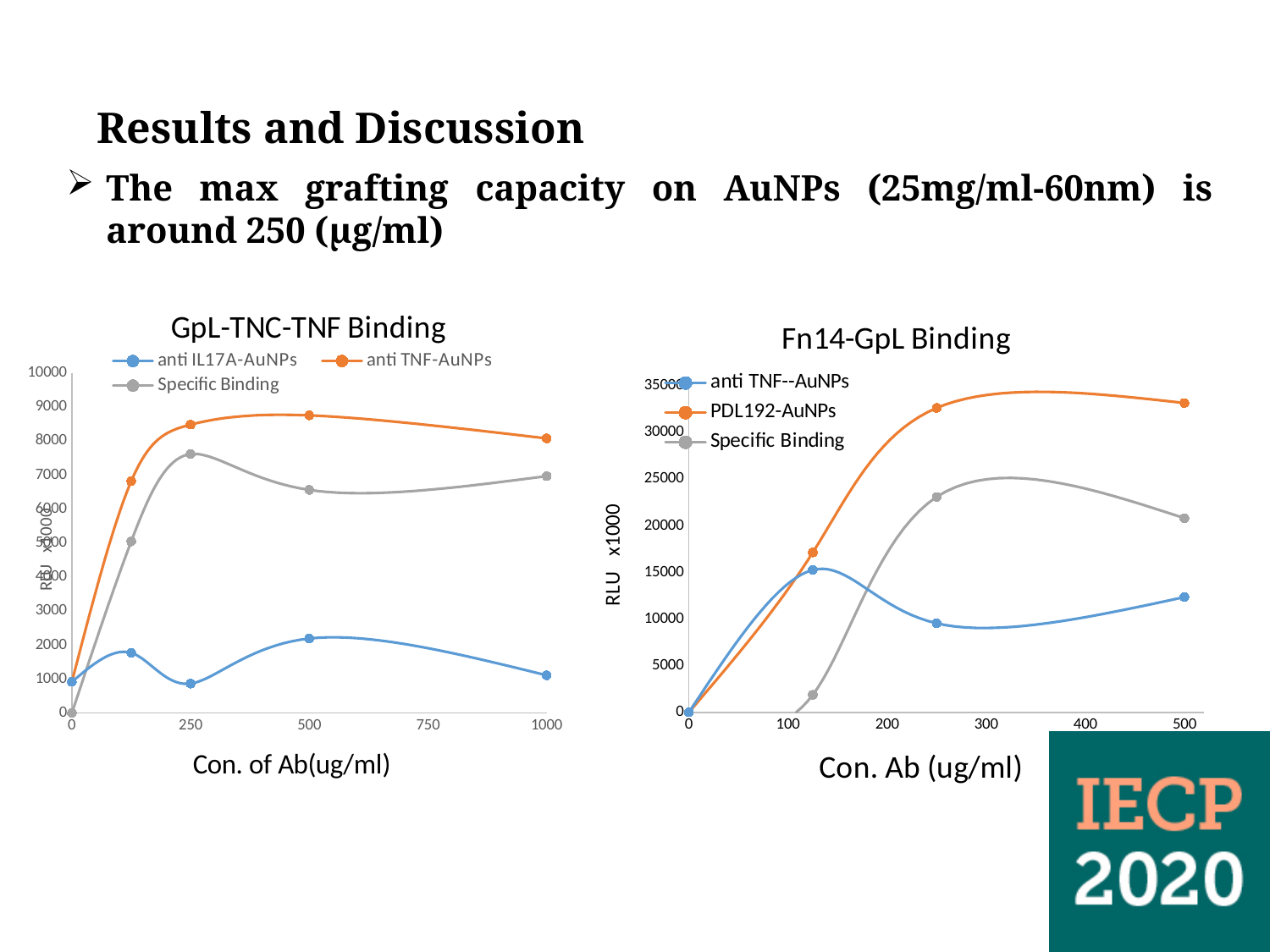
In the GpL-TNC-TNF Binding chart, which series has the lowest value at 250 ug/ml? anti IL17A-AuNPs In the Fn14-GpL Binding chart, which series has the lowest value at 125 ug/ml? Specific Binding In the Fn14-GpL Binding chart, is the value for Specific Binding at 250 ug/ml greater or less than 20000? greater What is the x-axis label of the Fn14-GpL Binding chart? Con. Ab (ug/ml) In the Fn14-GpL Binding chart, which is larger at 500 ug/ml: anti TNF--AuNPs or Specific Binding? Specific Binding In the Fn14-GpL Binding chart, is the value for PDL192-AuNPs at 500 ug/ml greater or less than 30000? greater In the GpL-TNC-TNF Binding chart, which series has the highest value at 1000 ug/ml? anti TNF-AuNPs What kind of chart is the GpL-TNC-TNF Binding chart on the left? line chart In the GpL-TNC-TNF Binding chart, is the value for anti TNF-AuNPs at 500 ug/ml greater or less than 8000? greater How many series does the legend of the Fn14-GpL Binding chart list? 3 How many series does the legend of the GpL-TNC-TNF Binding chart list? 3